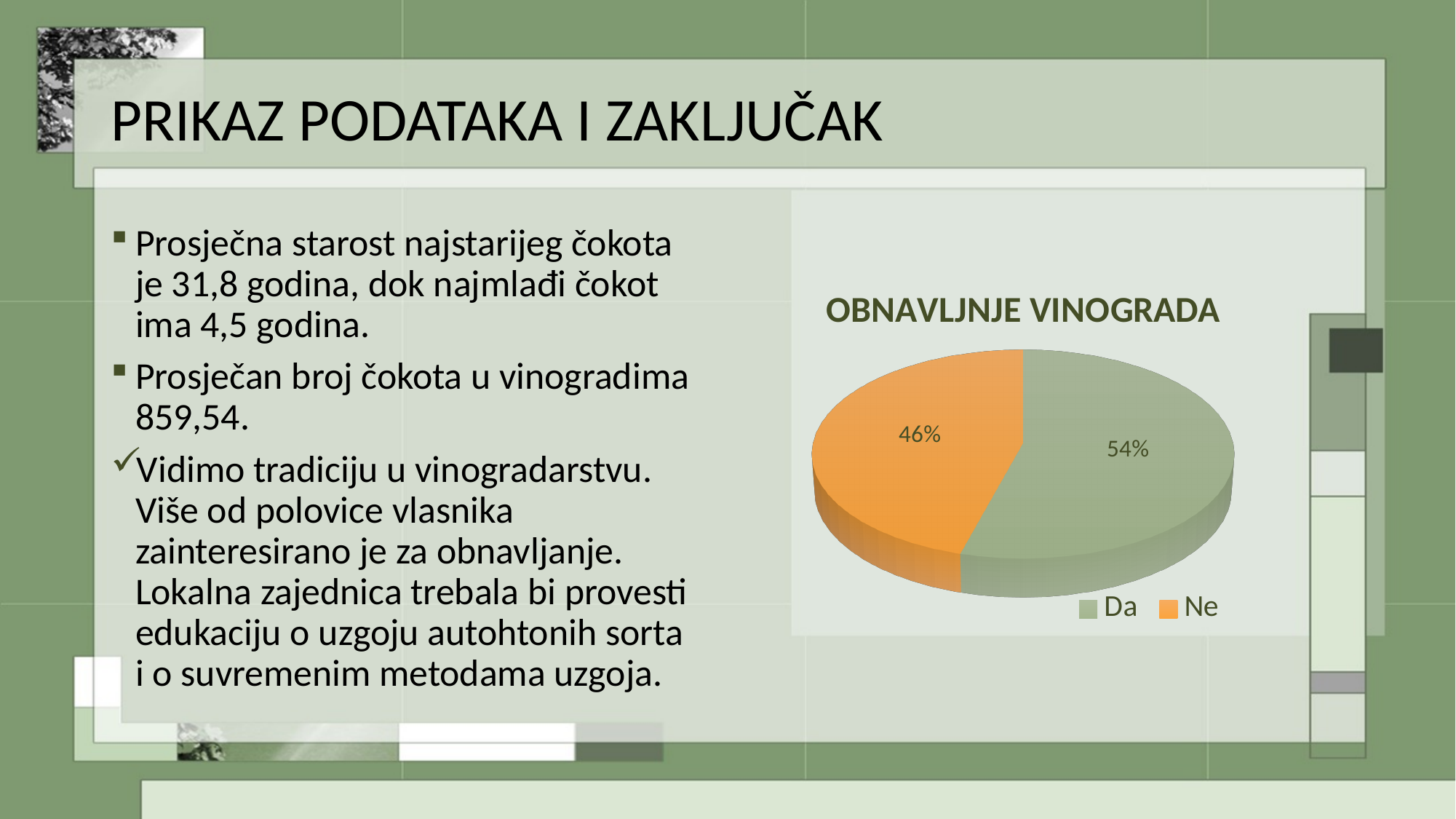
What is the difference in percentage points between the "Da" and "Ne" slices? 8 percentage points What share of the pie does "Da" represent? 54% How many entries does the legend list? 2 Which is larger, the "Da" slice or the "Ne" slice? Da What is the title of the chart? OBNAVLJNJE VINOGRADA How many slices does the pie chart have? 2 What share of the pie does "Ne" represent? 46% Which slice is the largest? Da Which slice is the smallest? Ne What colour is the "Ne" slice? orange What kind of chart is shown on the slide? pie chart